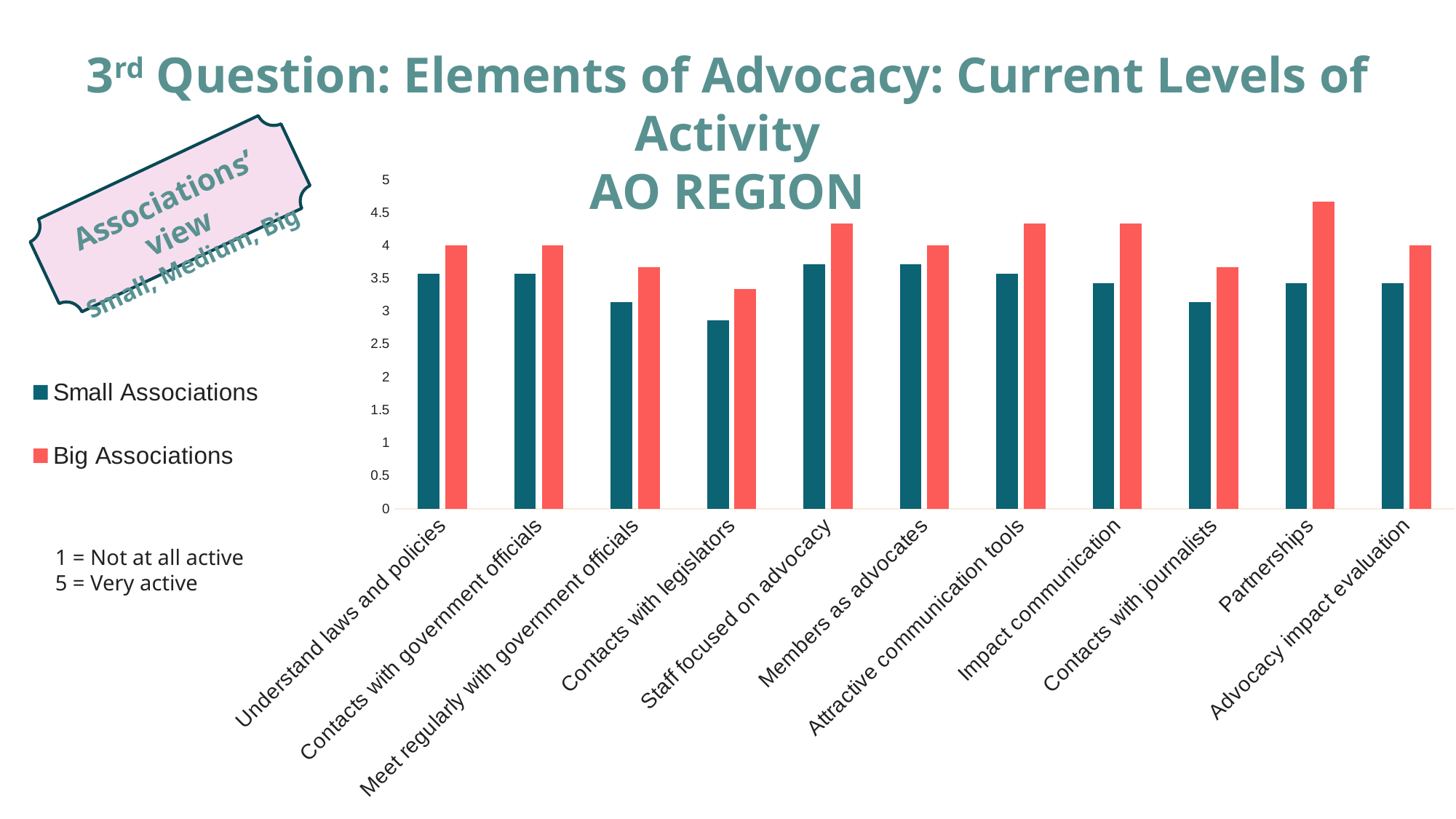
For Impact communication, which is larger: Small Associations or Big Associations? Big Associations Is the value for Small Associations on Meet regularly with government officials greater or less than 3? greater Is the value for Big Associations on Partnerships greater or less than 4.5? greater What value does the Big Associations bar reach for Members as advocates? 4 What kind of chart is shown on the slide? bar chart Is the value for Small Associations on Contacts with legislators greater or less than 3? less Which series is shown in red/coral bars? Big Associations How many categories are shown along the x axis? 11 Which category has the lowest value for Big Associations? Contacts with legislators Which category has the highest value for Big Associations? Partnerships How many series does the legend list? 2 Which category has the lowest value for Small Associations? Contacts with legislators